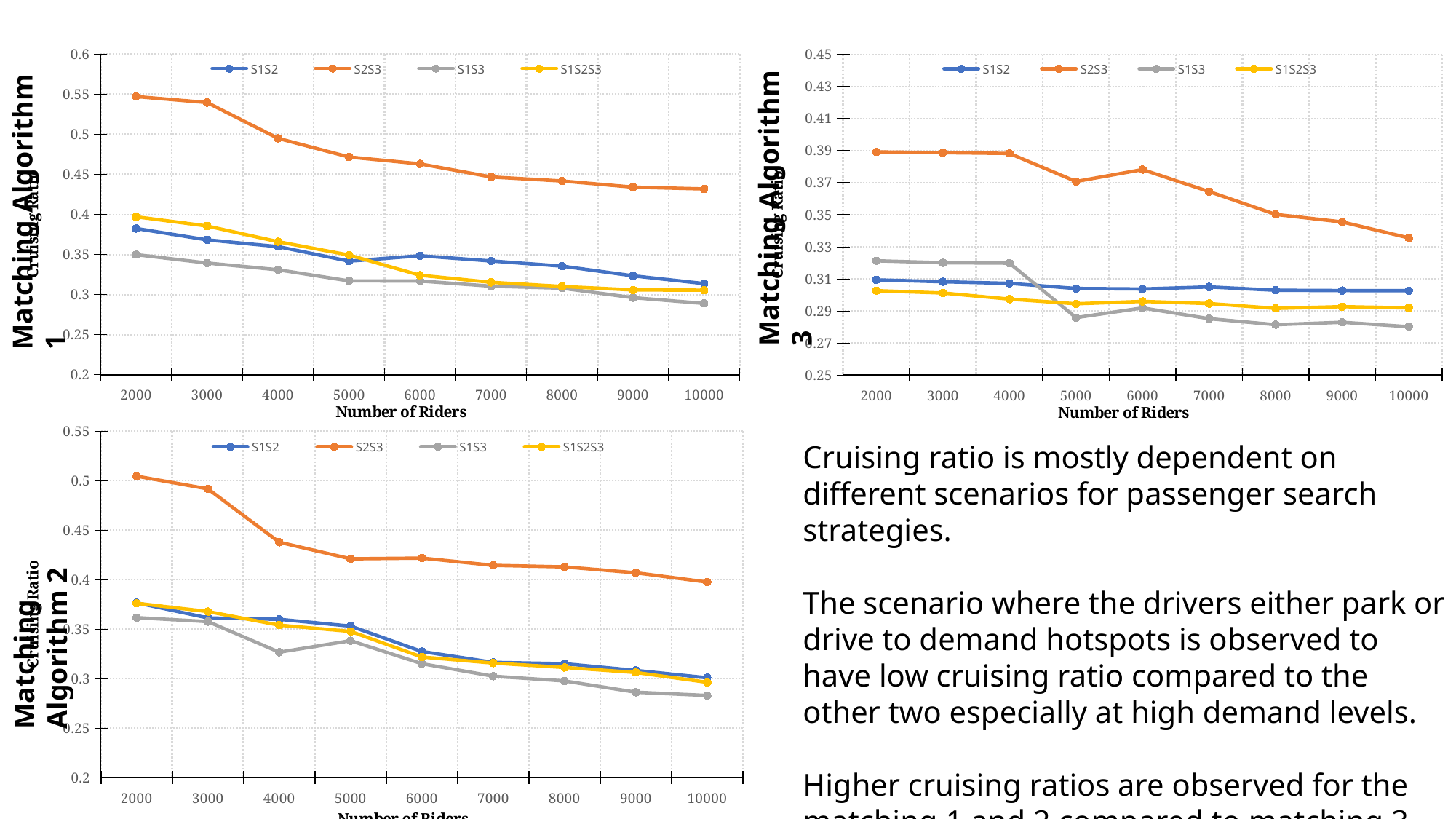
In the Matching Algorithm 2 chart, does the S2S3 series rise or fall as the number of riders increases? falls In the Matching Algorithm 3 chart, which series has the highest cruising ratio at 10000 riders? S2S3 How many Number of Riders values are plotted along the x axis of the Matching Algorithm 2 chart? 9 In the Matching Algorithm 3 chart, at 2000 riders, which is larger: S1S3 or S1S2S3? S1S3 In the Matching Algorithm 1 chart, which series has the highest cruising ratio at 2000 riders? S2S3 How many series does the legend of the Matching Algorithm 1 chart list? 4 In the Matching Algorithm 2 chart, is the value for S1S3 at 10000 riders greater or less than 0.3? less In the Matching Algorithm 3 chart, is the value for S2S3 at 2000 riders greater or less than 0.37? greater In the Matching Algorithm 1 chart, is the value for S2S3 at 2000 riders greater or less than 0.5? greater What kind of chart is the Matching Algorithm 1 chart? line chart What is the x-axis title of the Matching Algorithm 3 chart? Number of Riders In the Matching Algorithm 1 chart, which series has the lowest cruising ratio at 10000 riders? S1S3